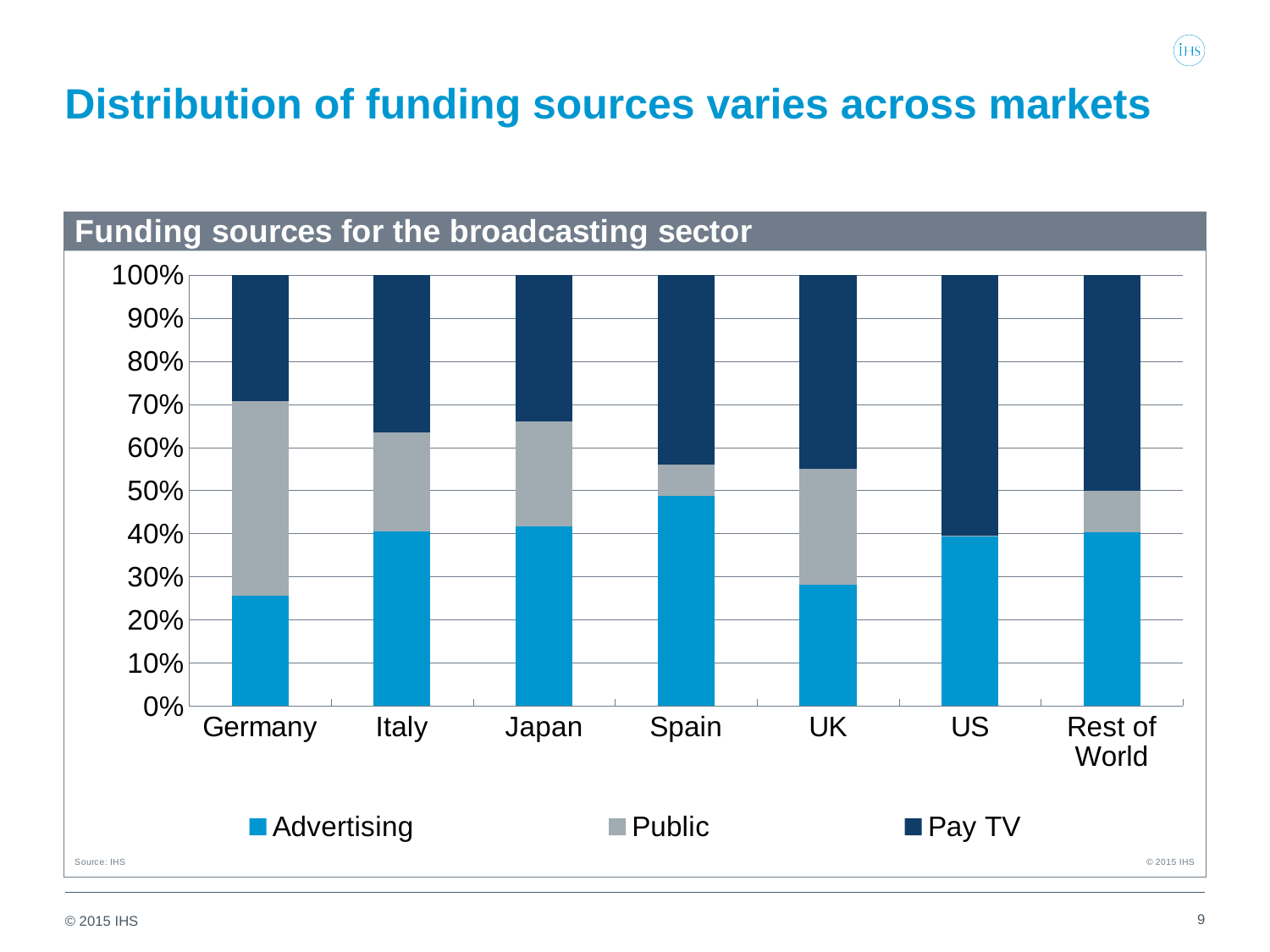
Is the Public share for Rest of World greater or less than 20%? less Which market has the smallest Public funding share? US Which market has the largest Public funding share? Germany How many markets (categories) are shown on the x axis of the chart? 7 Is the Advertising share for Spain greater or less than 40%? greater Is the Advertising share for Germany greater or less than 30%? less Which market has the largest Pay TV funding share? US What are the three funding sources listed in the legend? Advertising, Public, Pay TV What is the title of the chart? Funding sources for the broadcasting sector What kind of chart is shown on the slide? Stacked bar chart How many series does the legend list? 3 Which has the larger Advertising share, Spain or Germany? Spain